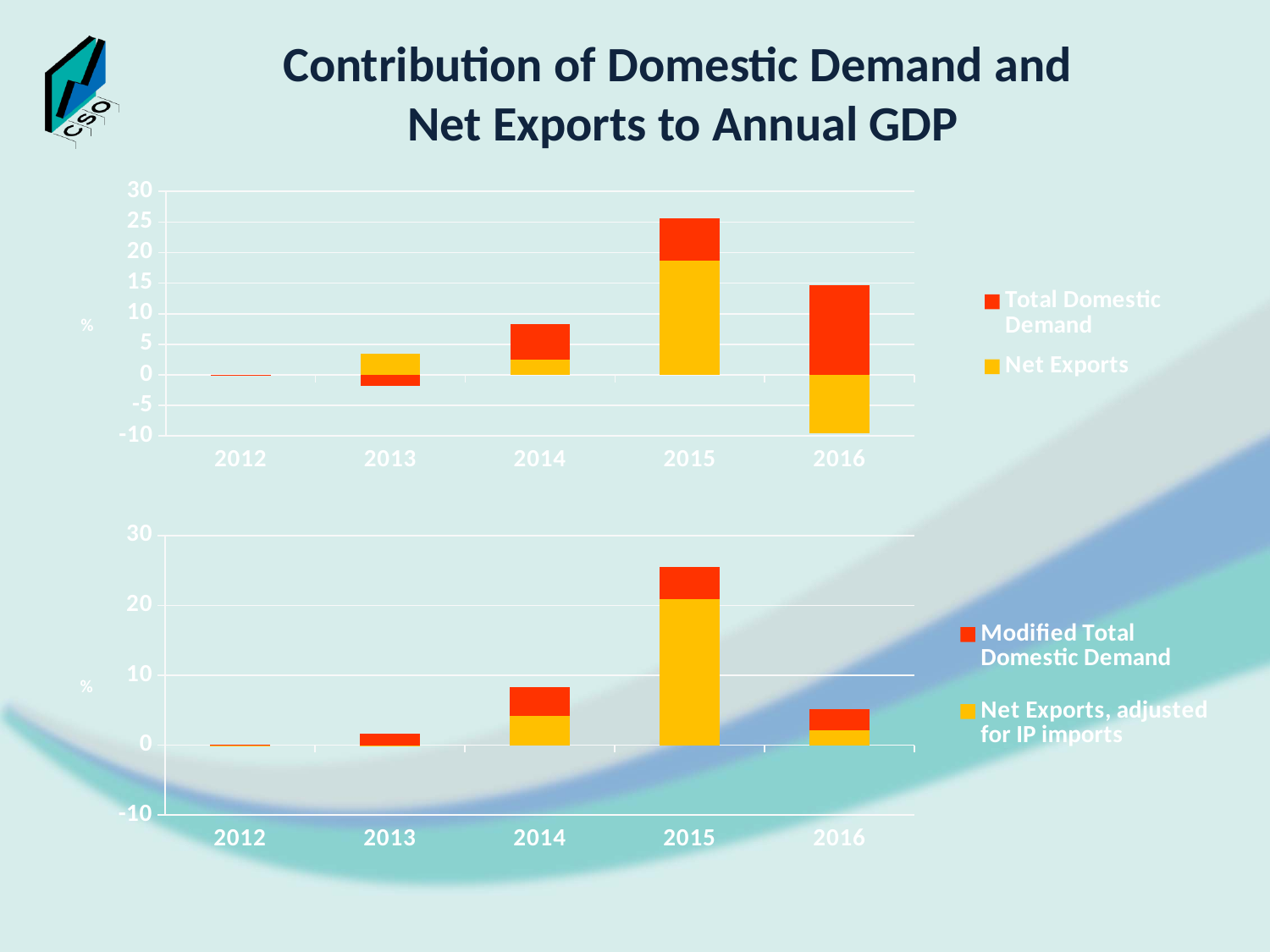
In the bottom chart, what is the name of the red series in the legend? Modified Total Domestic Demand In the bottom chart, which year has the tallest stacked bar? 2015 In the bottom chart, is the Net Exports, adjusted for IP imports value for 2015 greater or less than 10? greater In the top chart, which year has the larger Net Exports value, 2015 or 2016? 2015 How many series does the legend of the bottom chart list? 2 In the top chart, which series is shown in yellow? Net Exports How many years are shown on the x axis of the top chart? 5 In the top chart, which year has the tallest stacked bar above zero? 2015 What kind of chart is the top chart on the slide? Stacked bar chart In the top chart, is the Net Exports value for 2016 greater or less than -5? less In the top chart, is the Net Exports value for 2015 greater or less than 15? greater